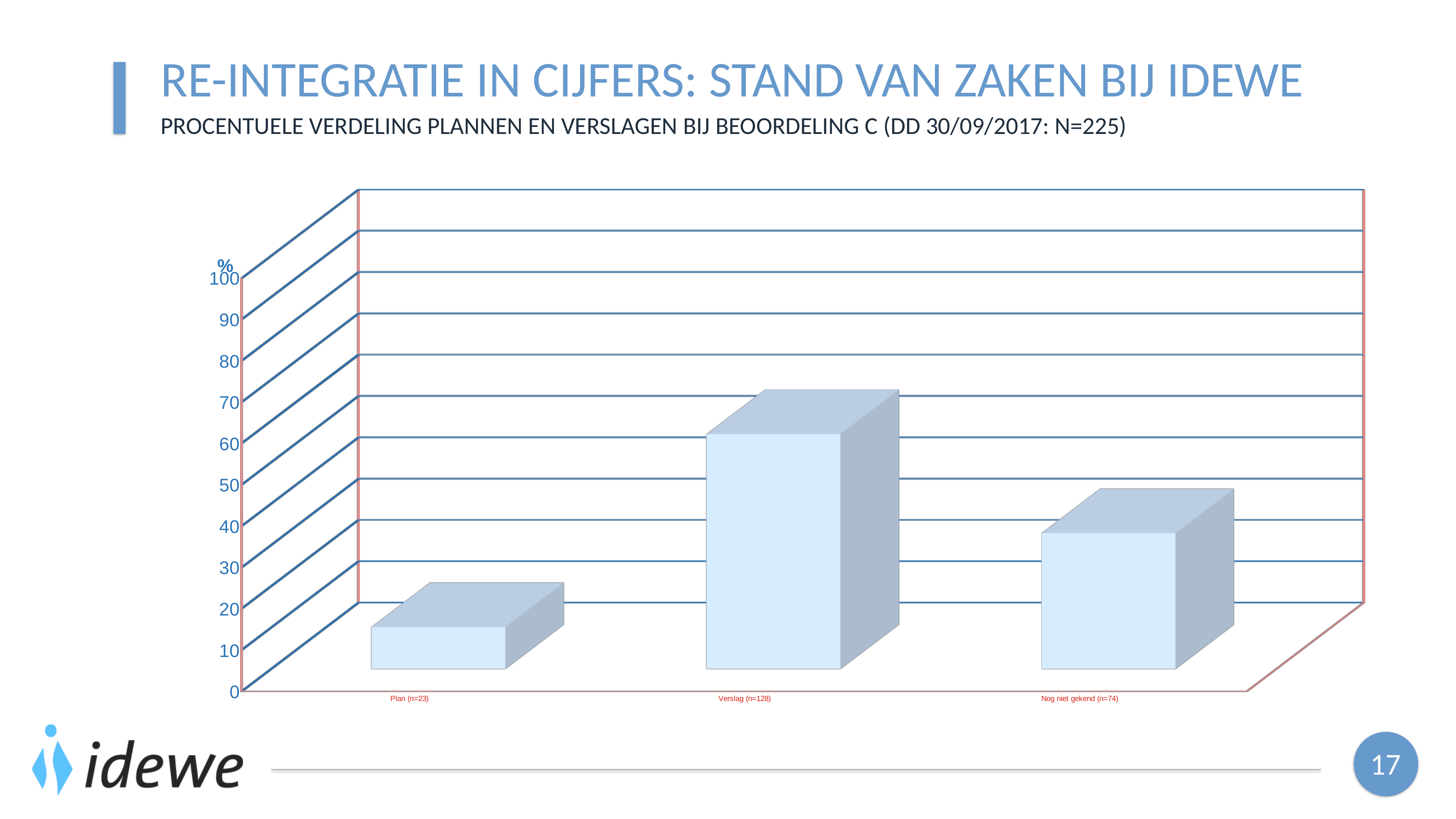
Which category has the highest percentage? Verslag (n=128) Which is larger, the value for Verslag or the value for Nog niet gekend? Verslag Which is larger, the value for Plan or the value for Nog niet gekend? Nog niet gekend What kind of chart is shown on the slide? bar chart How many categories (bars) does the chart show? 3 What is the n value shown in the label of the Verslag category? n=128 Is the value for Plan (n=23) greater or less than 30? less Is the value for Nog niet gekend (n=74) greater or less than 20? greater Is the value for Nog niet gekend (n=74) greater or less than 50? less Which category has the lowest percentage? Plan (n=23) What unit is shown on the vertical axis of the chart? %